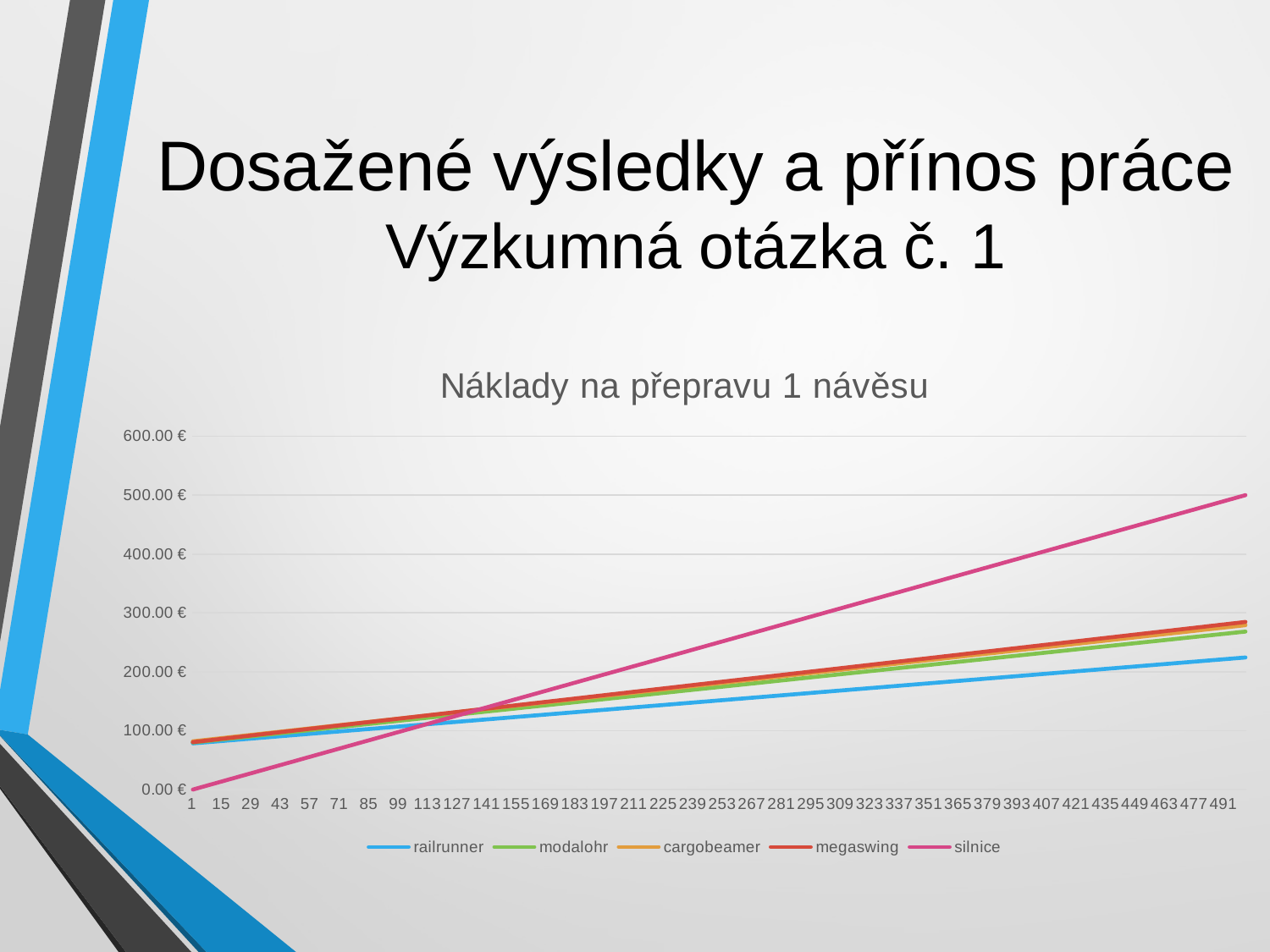
Is the value for megaswing at x = 491 greater or less than 200.00 €? greater Which series has the lowest value at the start of the x axis (1)? silnice How many series does the legend of the chart list? 5 What colour is the line for silnice in the legend? pink Which series has the lowest value at the right end of the x axis (491)? railrunner Do the values for silnice rise or fall along the x axis? rise Is the value for silnice at x = 491 greater or less than 400.00 €? greater What is the title of the chart? Náklady na přepravu 1 návěsu Is the value for railrunner at x = 491 greater or less than 300.00 €? less At x = 491, which is larger: silnice or railrunner? silnice Which series has the highest value at the right end of the x axis (491)? silnice What type of chart is shown on the slide? line chart